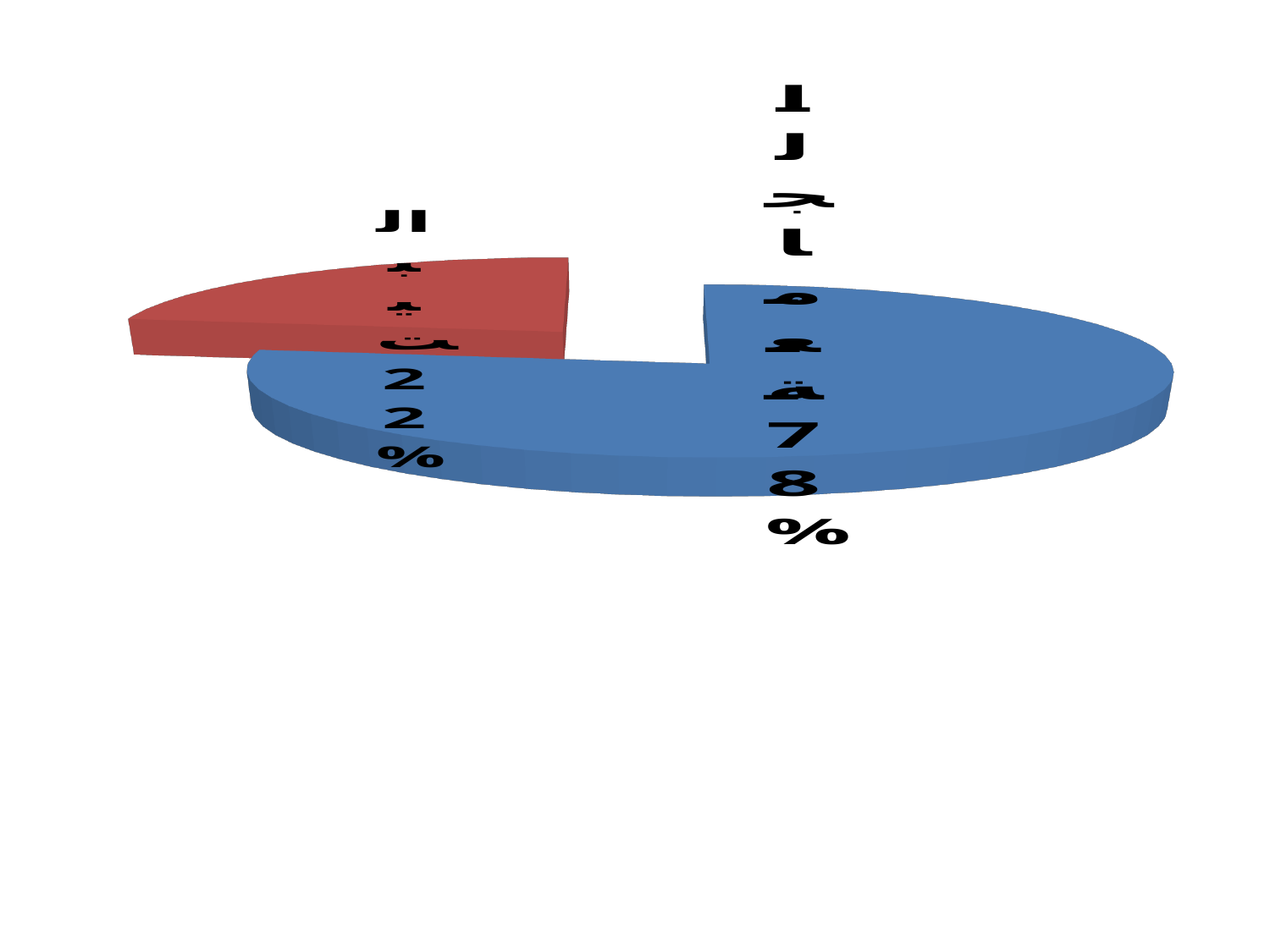
Which is larger, the blue slice or the red slice? the blue slice What colour is the largest slice of the pie chart? blue What percentage is shown on the blue slice of the pie chart? 78% What kind of chart is shown on the slide? pie chart What do the two slice percentages add up to? 100% Which slice of the pie chart is the largest? the blue slice (78%) What percentage is shown on the red slice of the pie chart? 22% Which slice of the pie chart is the smallest? the red slice (22%) What is the difference in percentage points between the blue slice and the red slice? 56 What share of the pie does the red slice represent? 22% How many slices does the pie chart have? 2 Is the pie chart drawn in 3D or flat 2D? 3D